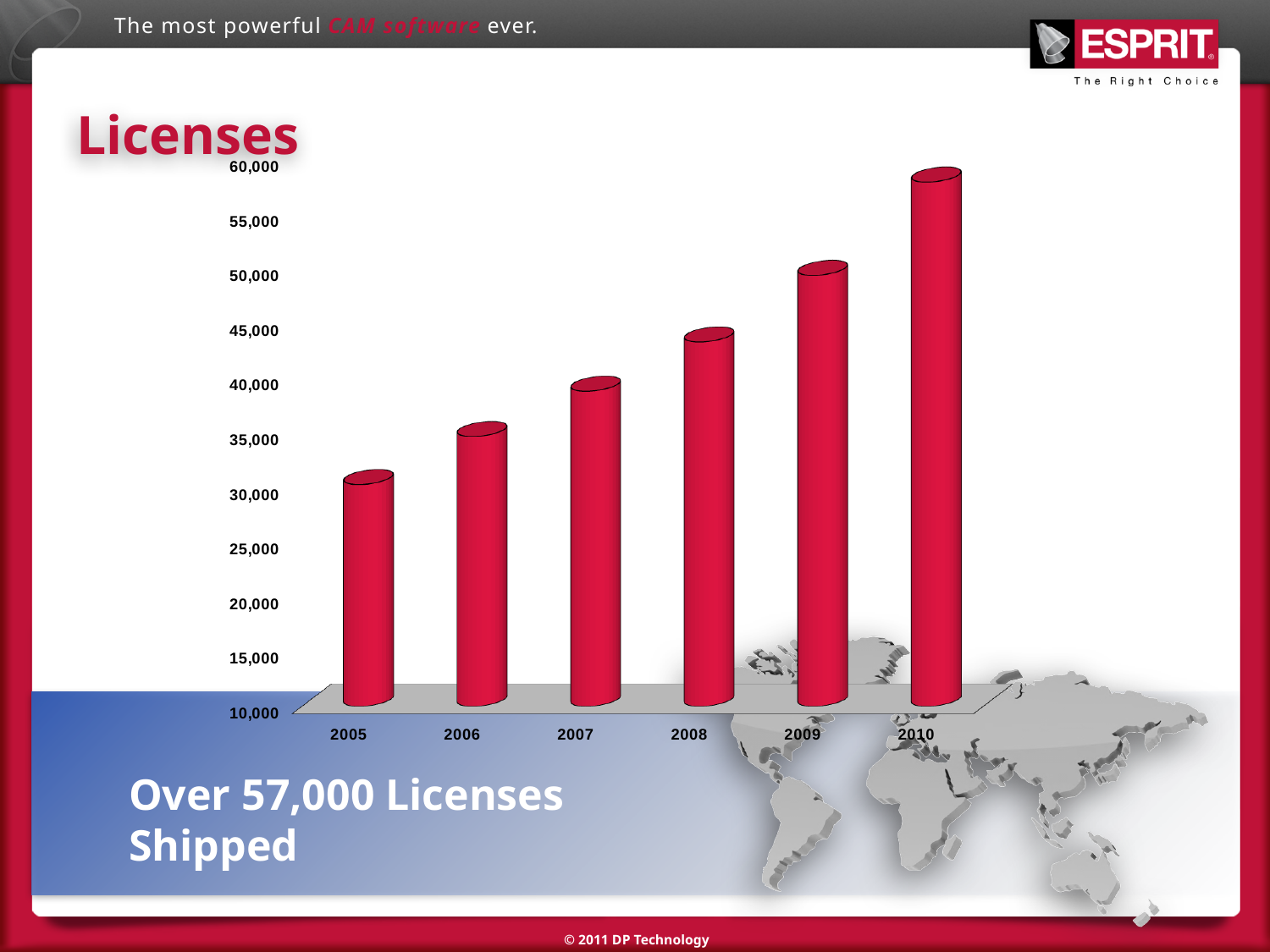
Is the value for 2009 greater or less than 45,000? greater What is the title of the chart? Licenses What kind of chart is shown on the slide? bar chart Which year has the highest number of licenses? 2010 Is the value for 2007 greater or less than 35,000? greater Which year has the lowest number of licenses? 2005 Which is larger, the value for 2009 or the value for 2007? 2009 Is the value for 2005 greater or less than 35,000? less Do the values rise or fall from 2005 to 2010? rise How many years are shown on the x axis of the chart? 6